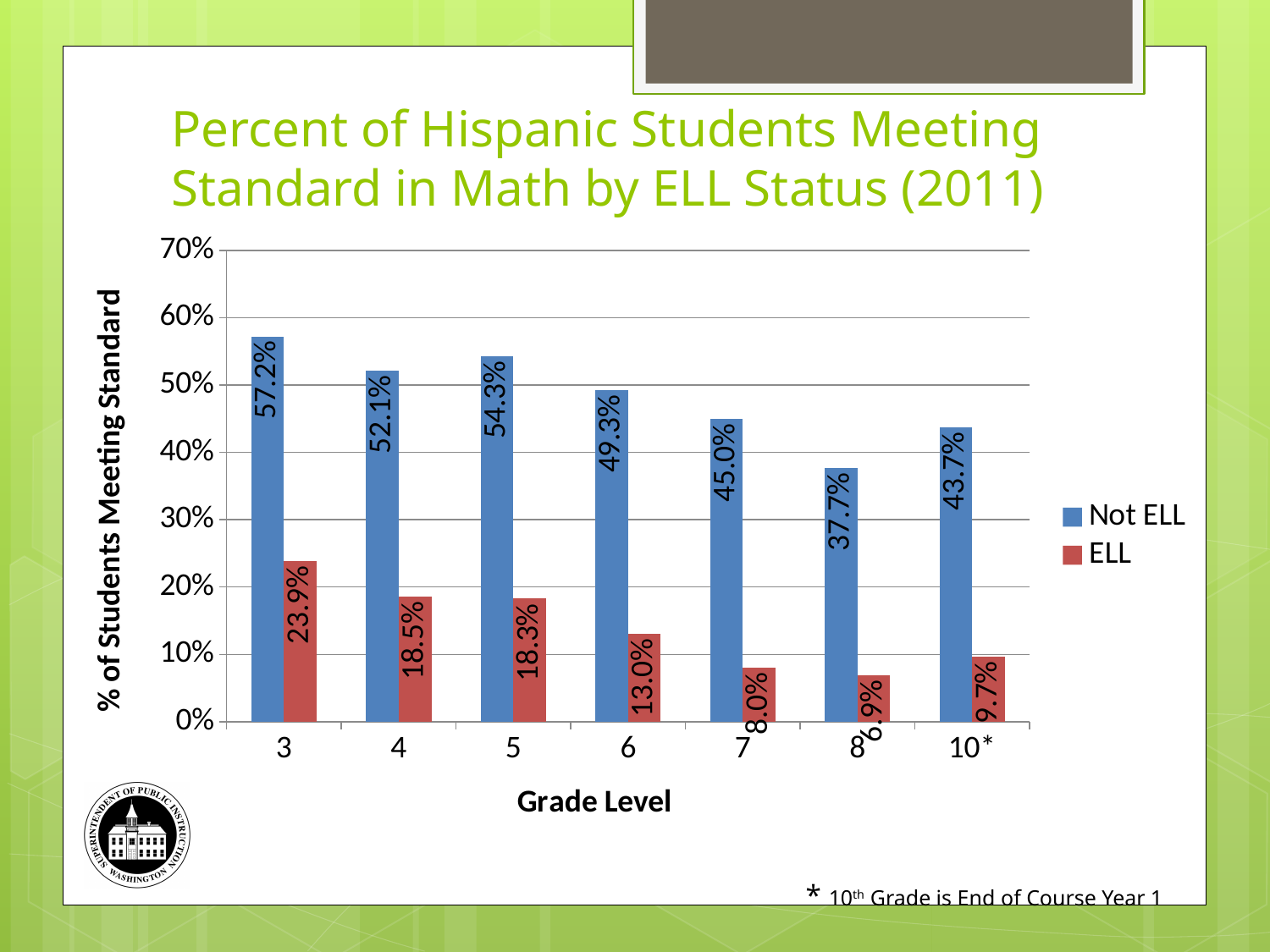
Which grade level has the lowest ELL value? 8 What is the ELL value for grade 10*? 9.7% Which is larger, the Not ELL value for grade 5 or the Not ELL value for grade 4? Grade 5 Which grade level has the highest Not ELL value? 3 How many grade levels are shown on the x axis? 7 What is the difference between the Not ELL and ELL values for grade 7? 37.0% What percent of ELL Hispanic students met the math standard in grade 6? 13.0% What percent of Not ELL Hispanic students met the math standard in grade 3? 57.2% How many series does the legend list? 2 What is the label of the y axis? % of Students Meeting Standard What is the Not ELL value for grade 8? 37.7% What kind of chart is shown on the slide? Bar chart